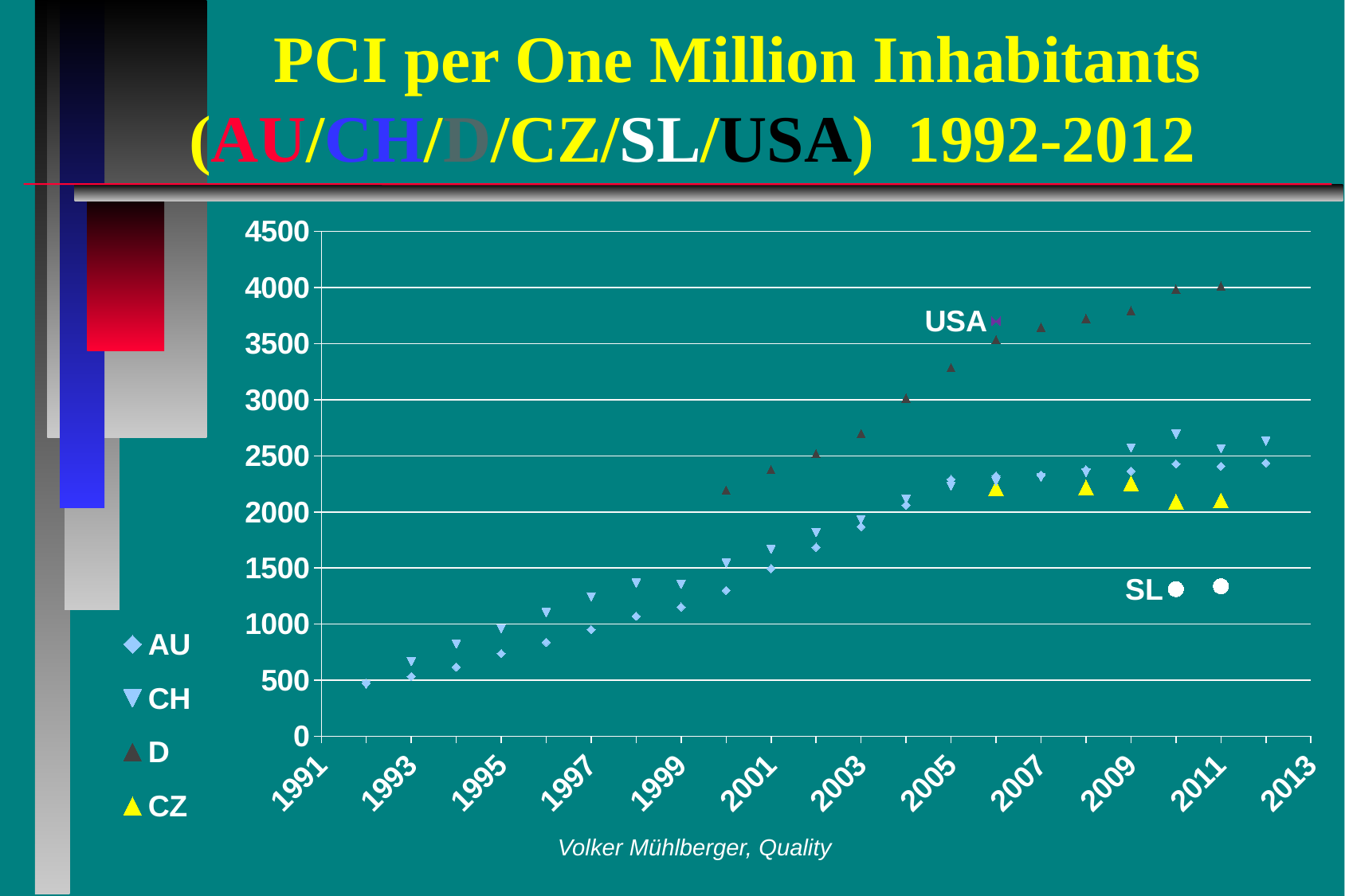
Which series has the highest value in 2011? D What kind of chart is shown on the slide? scatter chart In 2009, which is larger, the value for D or the value for AU? D Is the value for CH in 2010 greater or less than 2500? greater Do the values for the D series rise or fall from 2001 to 2011? rise Is the value for AU in 1999 greater or less than 1000? greater Is the value for SL in 2010 greater or less than 1500? less What is the title of the chart on the slide? PCI per One Million Inhabitants (AU/CH/D/CZ/SL/USA) 1992-2012 How many series does the legend list? 4 Which series does the legend show with a yellow triangle marker? CZ